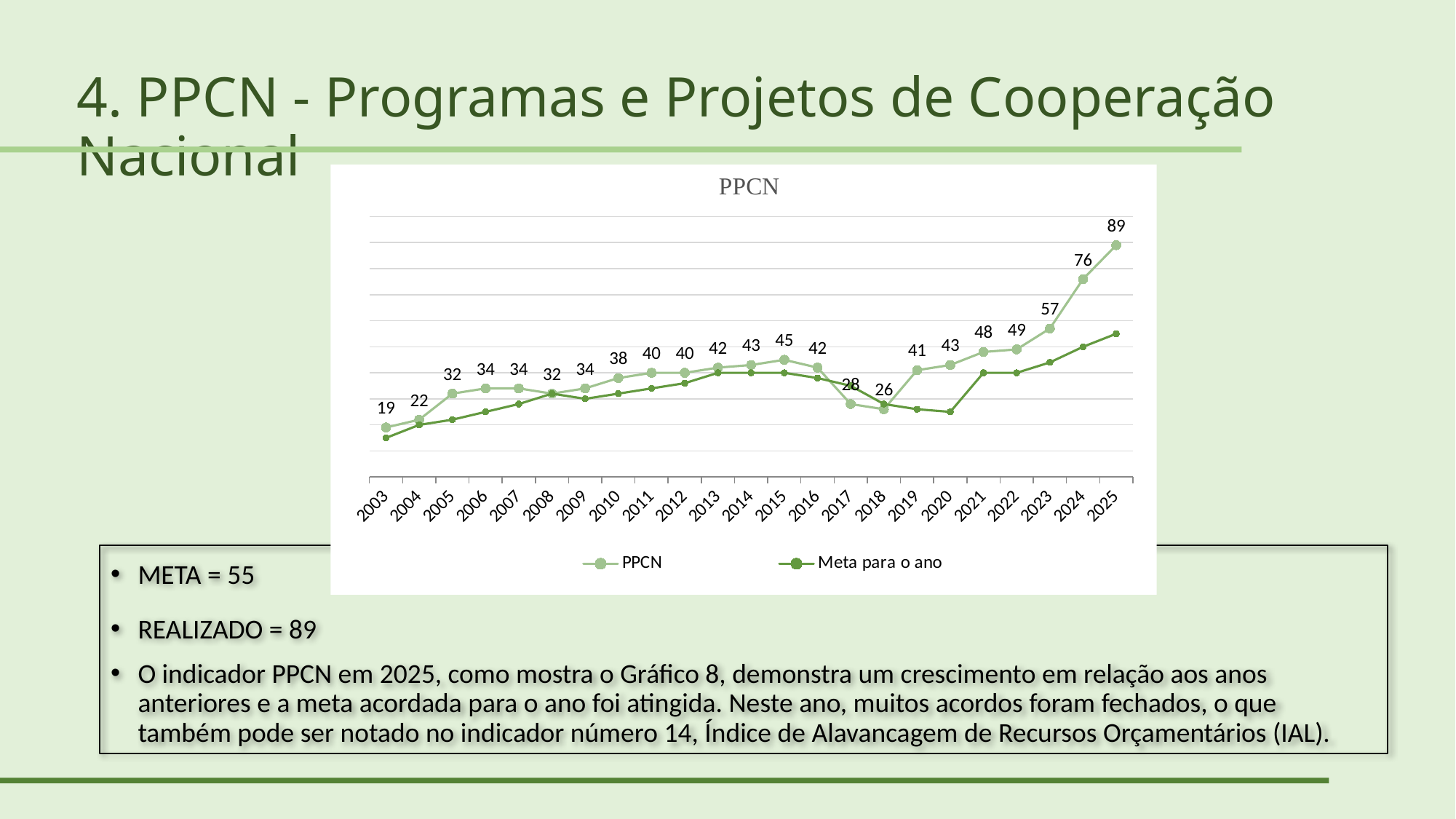
What is the PPCN value for 2017? 28 What kind of chart is shown? Line chart Which is larger, the PPCN value for 2015 or for 2020? 2015 What is the difference between the PPCN values for 2025 and 2024? 13 What is the difference between the PPCN values for 2016 and 2017? 14 What is the PPCN value for 2025? 89 How many years are shown on the x axis? 23 Does the PPCN series rise or fall from 2021 to 2025? Rise Which year has the highest PPCN value? 2025 What is the PPCN value for 2010? 38 How many series does the legend list? 2 Which year has the lowest PPCN value? 2003